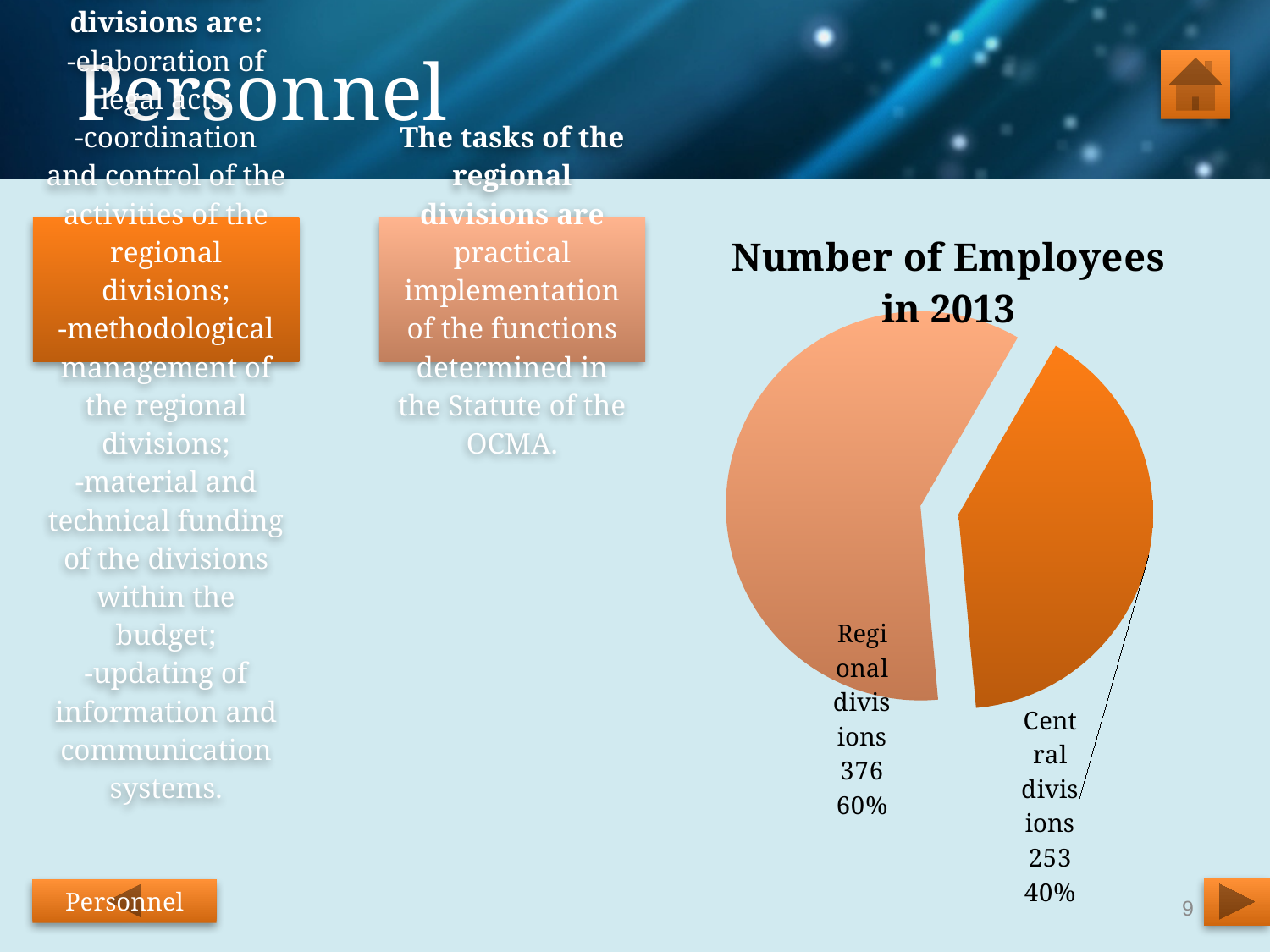
What is the difference in the number of employees between the Regional divisions and the Central divisions? 123 What is the number of employees in the Regional divisions? 376 What kind of chart is shown on the slide? pie chart What is the total number of employees shown in the pie chart? 629 What share of the pie do the Regional divisions represent? 60% Which has more employees, the Regional divisions or the Central divisions? Regional divisions Which category has the smallest number of employees? Central divisions What share of the pie do the Central divisions represent? 40% How many slices does the pie chart have? 2 What is the number of employees in the Central divisions? 253 What is the title of the chart? Number of Employees in 2013 Which category has the largest number of employees? Regional divisions